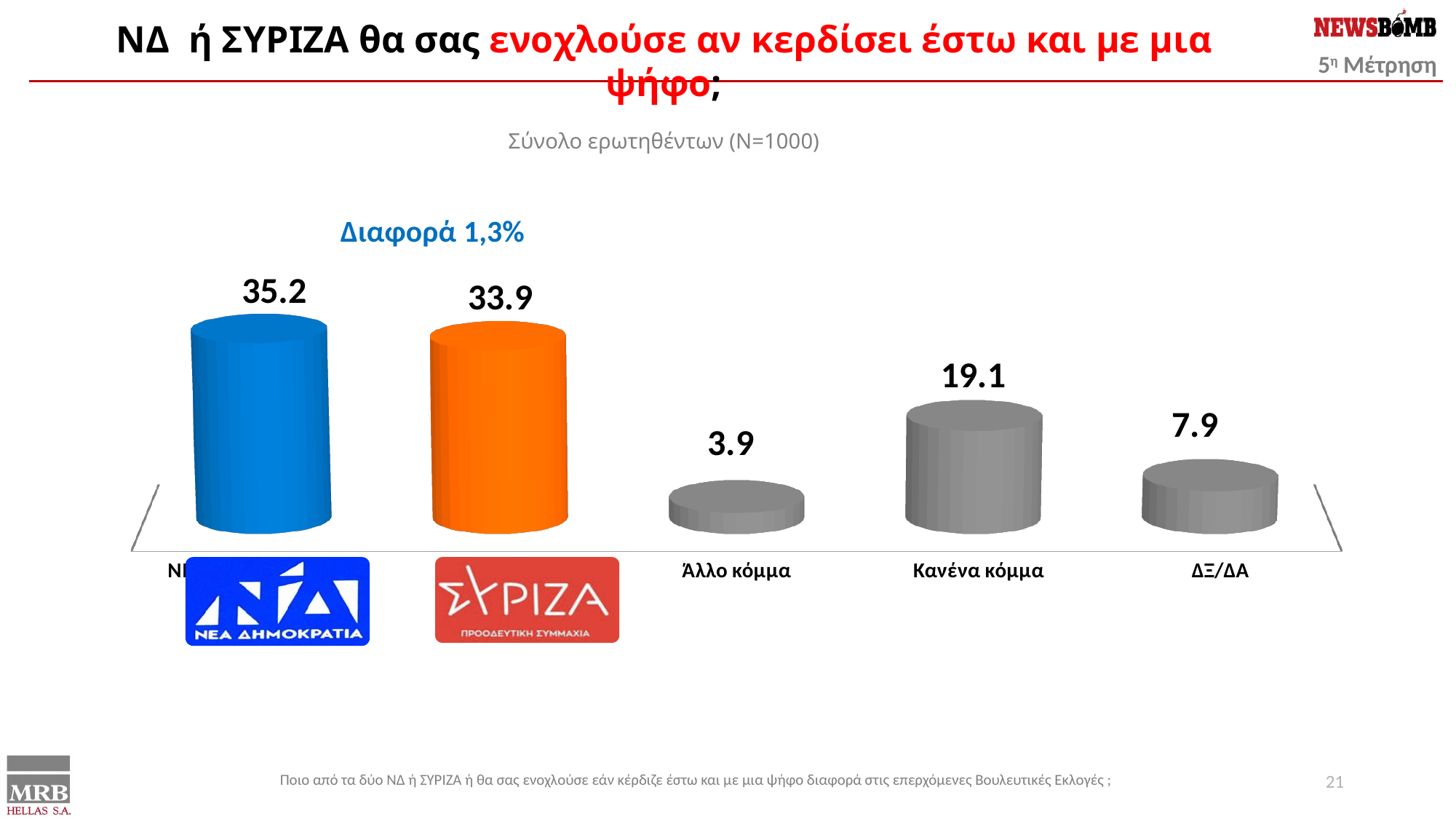
What is the difference between the values for Κανένα κόμμα and ΔΞ/ΔΑ? 11.2 What kind of chart is shown on the slide? Bar chart Which category has the highest value? ΝΔ (Νέα Δημοκρατία) What is the value for ΔΞ/ΔΑ? 7.9 What is the value for Κανένα κόμμα? 19.1 What is the value for ΝΔ (Νέα Δημοκρατία)? 35.2 What is the value for Άλλο κόμμα? 3.9 What is the difference between the values for ΝΔ and ΣΥΡΙΖΑ? 1.3 Which is larger, the value for Κανένα κόμμα or the value for ΔΞ/ΔΑ? Κανένα κόμμα Which category has the lowest value? Άλλο κόμμα How many categories are shown in the chart? 5 What is the value for ΣΥΡΙΖΑ? 33.9